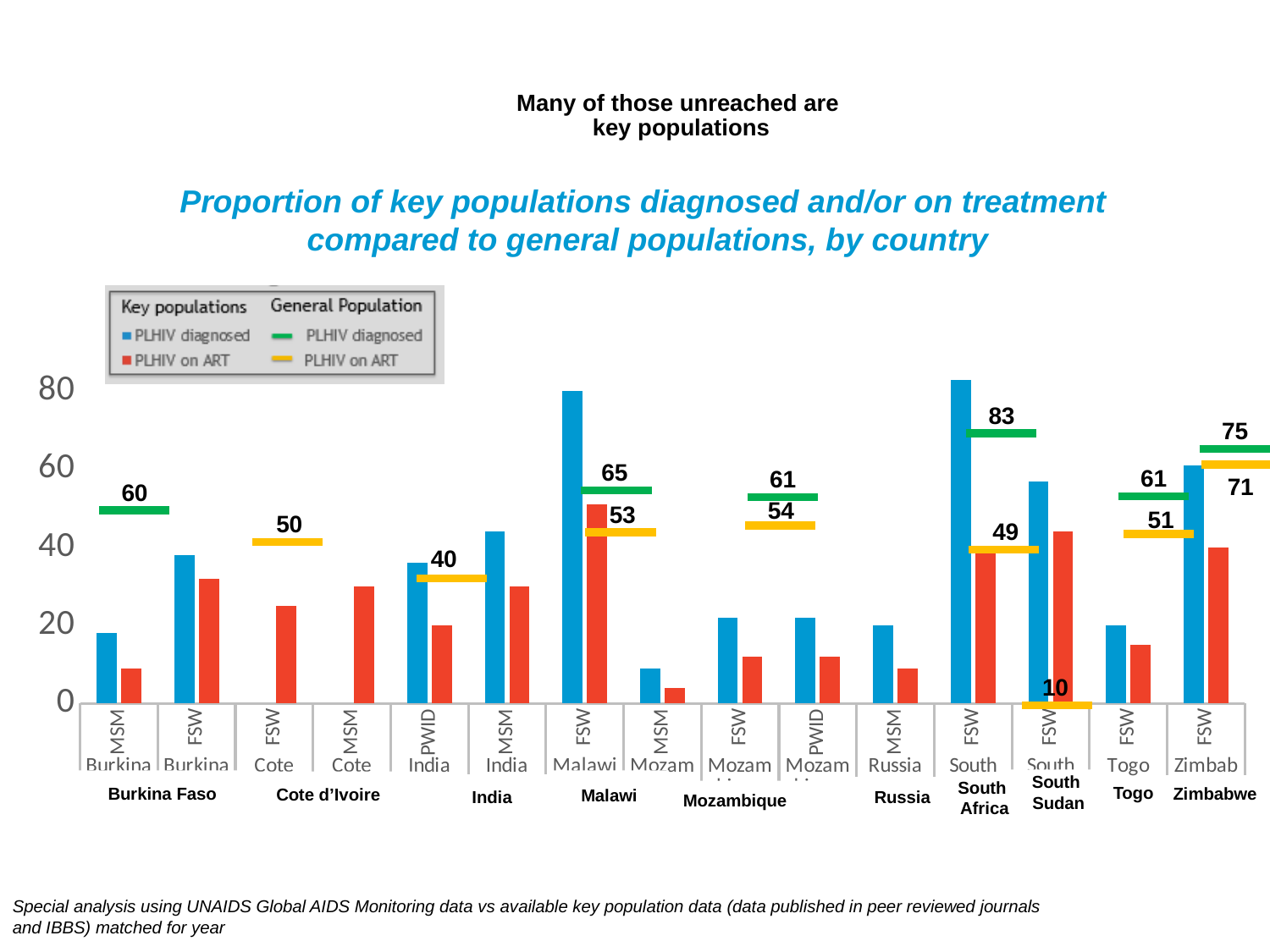
Is the key population PLHIV diagnosed bar for FSW in Malawi greater or less than 60? greater For Malawi, what is the difference between the general population PLHIV diagnosed value and the PLHIV on ART value? 12 For South Africa, what is the difference between the general population PLHIV diagnosed value (83) and the PLHIV on ART value (49)? 34 Is the key population PLHIV diagnosed bar for MSM in Burkina Faso greater or less than 20? less What is the general population PLHIV on ART value shown for South Sudan? 10 Which is larger: the general population PLHIV on ART value for Zimbabwe or for Mozambique? Zimbabwe How many countries are shown along the x axis of the chart? 10 What is the general population PLHIV on ART value shown for Zimbabwe? 71 How many series does the chart legend list? 4 What is the general population PLHIV diagnosed value shown for South Africa? 83 Which country has the lowest labelled general population PLHIV on ART value? South Sudan Which country has the highest labelled general population PLHIV diagnosed value? South Africa